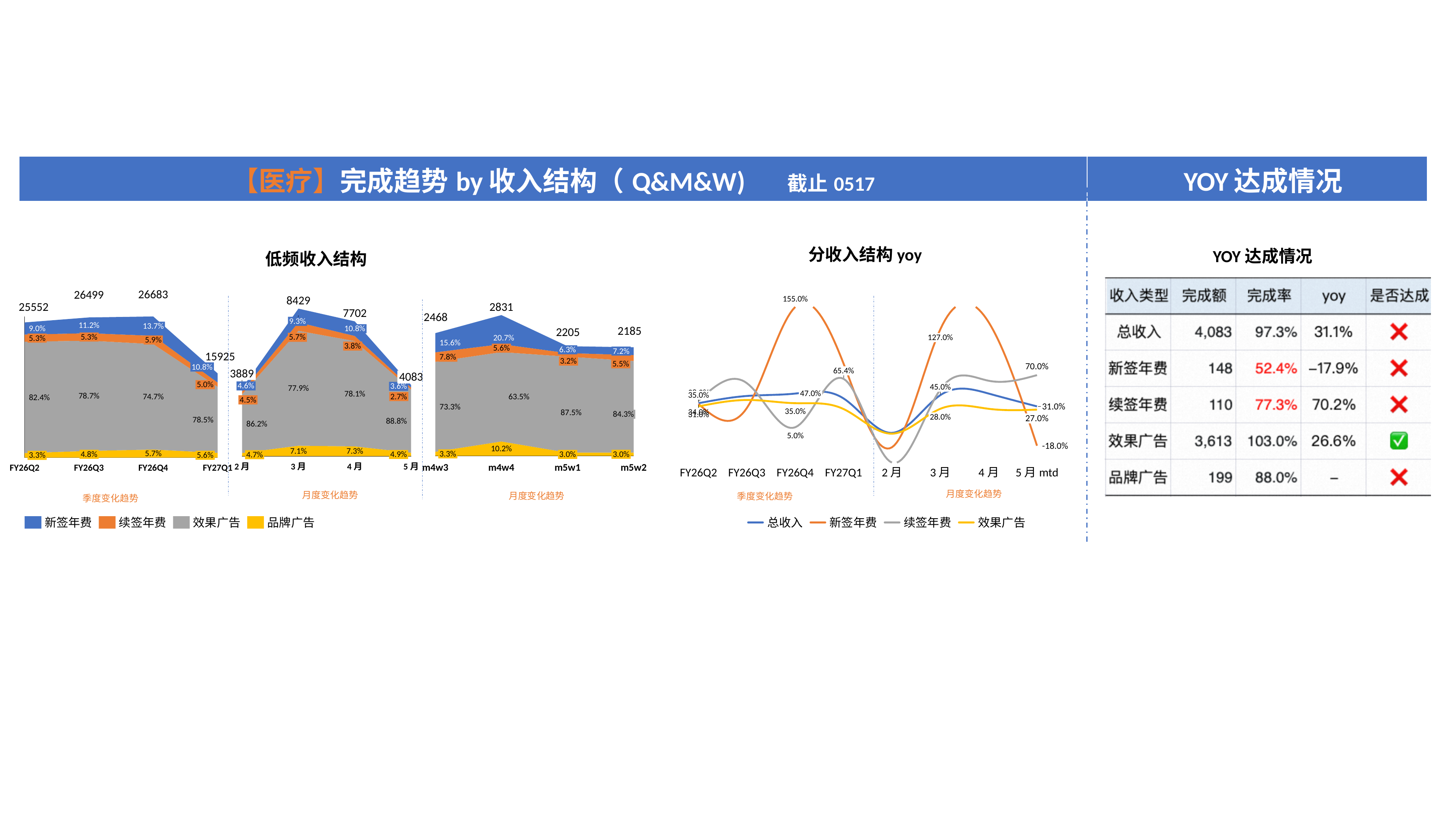
What kind of chart is 分收入结构 yoy? Line chart In the 低频收入结构 chart, what share does 品牌广告 have in 4月? 7.3% In the 分收入结构 yoy chart, what is the 续签年费 yoy value at 5月 mtd? 70.0% In the 低频收入结构 chart, which has the larger total, m4w4 or m5w1? m4w4 In the 低频收入结构 chart, what share does 新签年费 have in m4w4? 20.7% How many series does the legend of the 低频收入结构 chart list? 4 In the 低频收入结构 chart, which quarter among FY26Q2 to FY27Q1 has the highest total? FY26Q4 In the 低频收入结构 chart, what share does 效果广告 have in FY26Q2? 82.4% In the 低频收入结构 chart, which month among 2月, 3月, 4月 and 5月 has the lowest total? 2月 In the 低频收入结构 chart, what is the total value shown for FY26Q4? 26683 In the 低频收入结构 chart, what is the difference between the totals for 3月 and 4月? 727